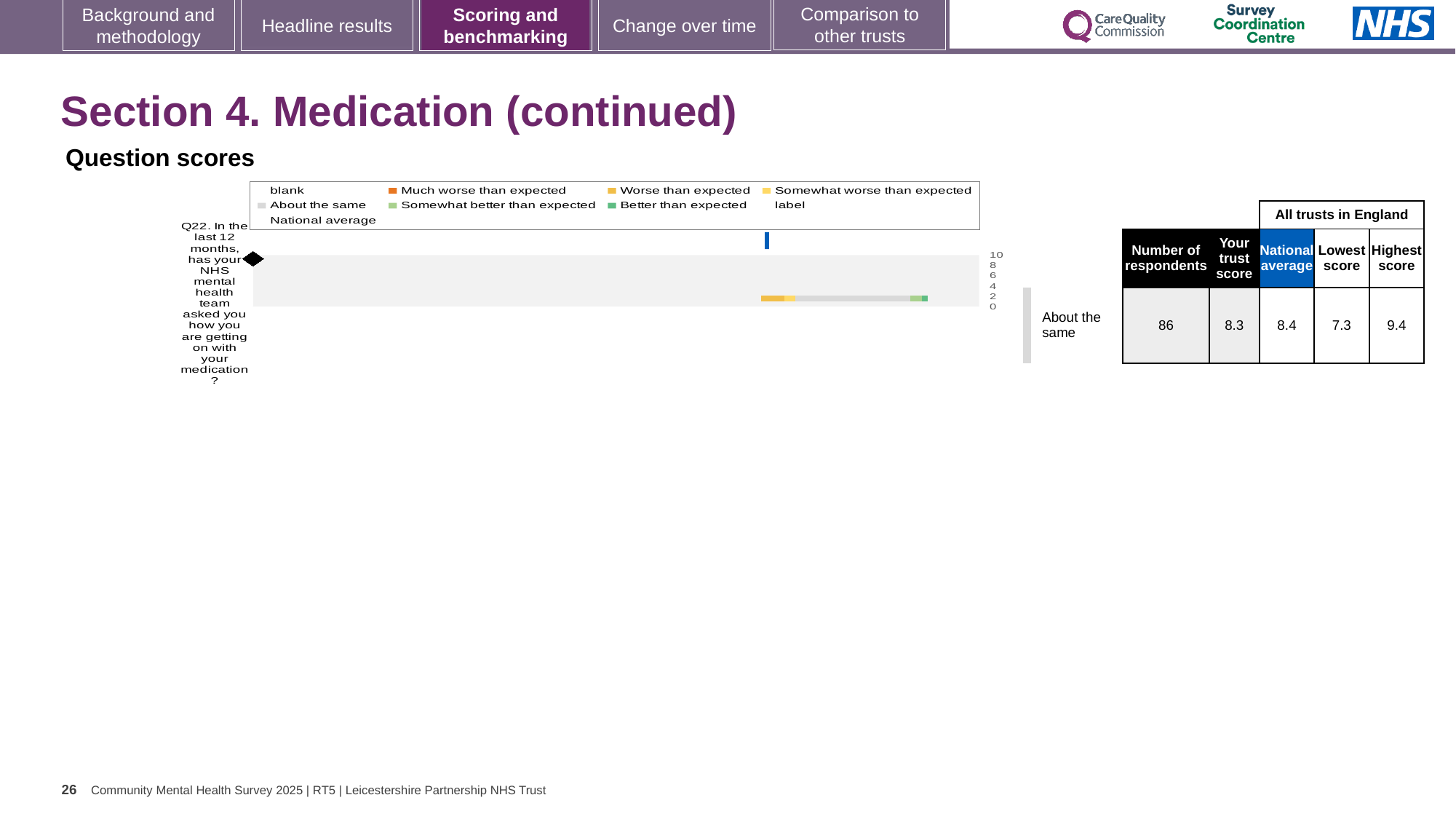
What is the national average score for Q22? 8.4 What is the difference between the highest and lowest scores for Q22 across all trusts in England? 2.1 How many questions (categories) are plotted on the chart? 1 What is the lowest score among all trusts in England for Q22? 7.3 Which question is plotted on the chart? Q22. In the last 12 months, has your NHS mental health team asked you how you are getting on with your medication? How is the trust's Q22 score categorised relative to what is expected? About the same What is the highest score among all trusts in England for Q22? 9.4 How many respondents answered Q22? 86 Which is larger for Q22, the trust's score or the national average? national average What is the trust's score for Q22 according to the table next to the chart? 8.3 Which legend entry is shown with a dark green marker? Better than expected What kind of chart is used to show the question score for Q22? bar chart